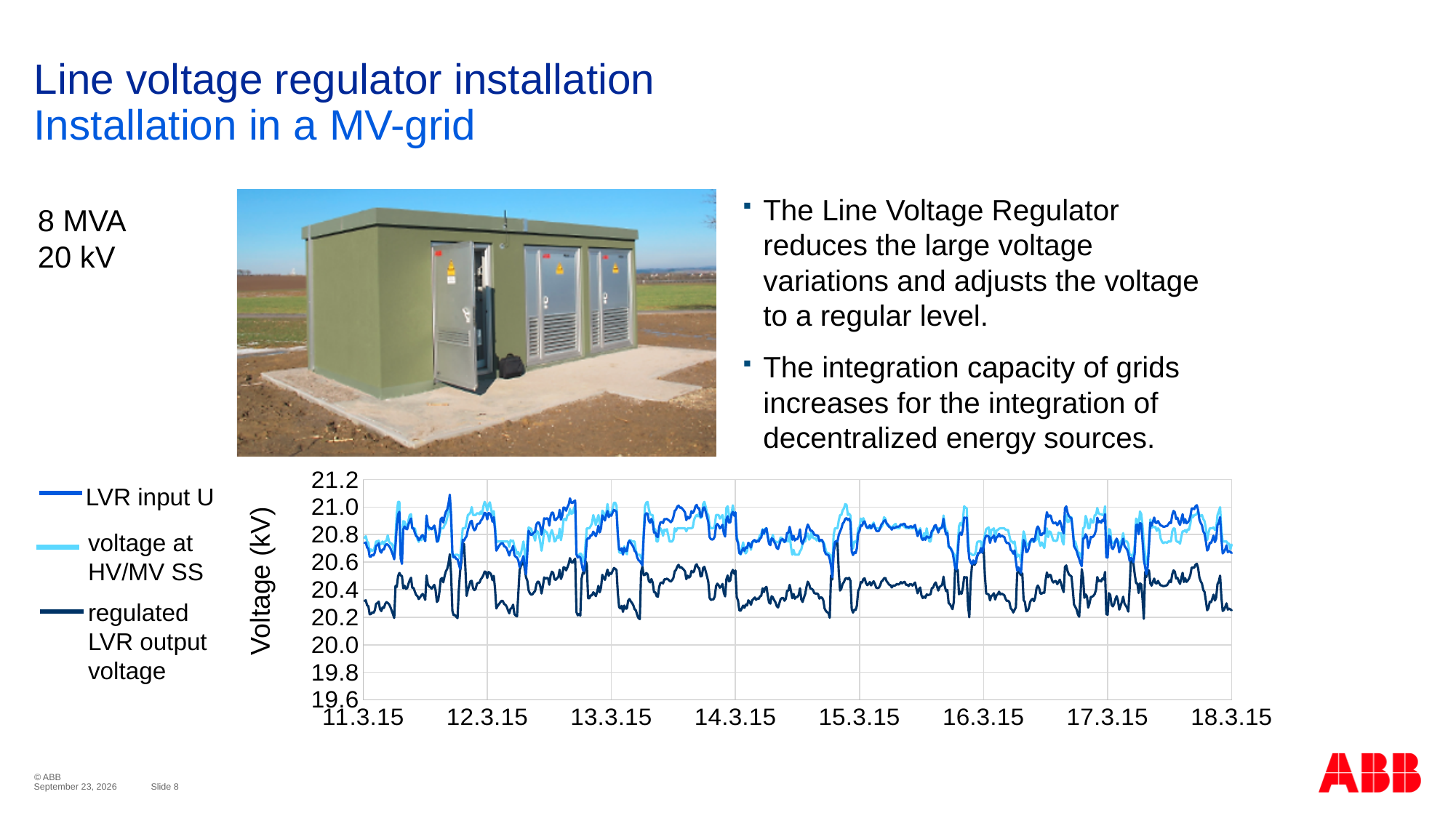
Is the regulated LVR output voltage greater or less than 20.8 kV throughout the period shown? less What kind of chart is shown on the slide? line chart Is the regulated LVR output voltage greater or less than 20.0 kV throughout the period shown? greater Which series is higher on the chart: LVR input U or regulated LVR output voltage? LVR input U What is the first date shown on the chart's horizontal axis? 11.3.15 Is the lowest value plotted on the chart greater or less than 20.0 kV? greater Which series on the chart has the lowest voltage values throughout the period? regulated LVR output voltage What is the title of the chart's vertical axis? Voltage (kV) How many series does the chart's legend list? 3 How many dates are labelled on the chart's horizontal axis? 8